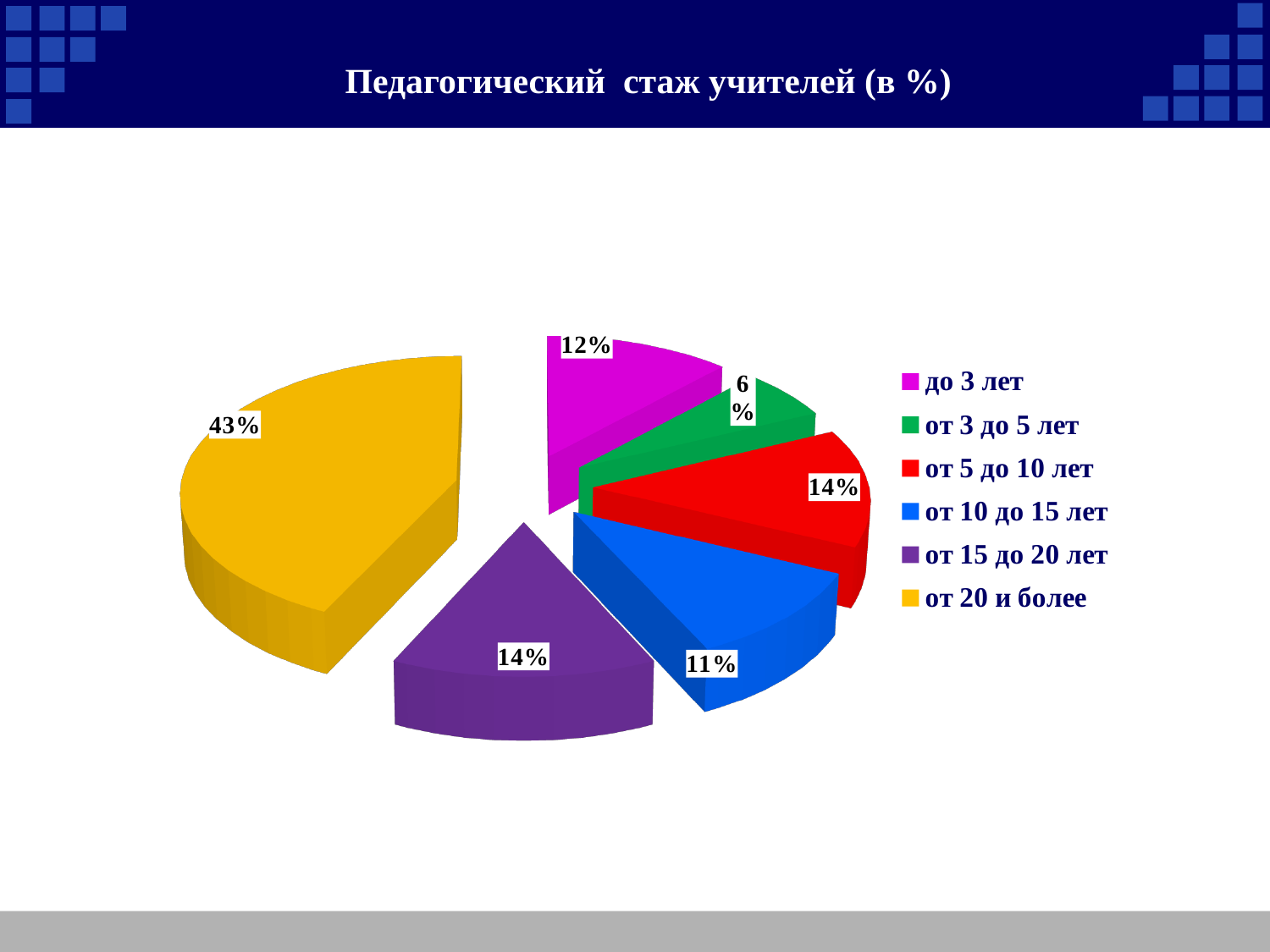
What type of chart is shown on the slide? Pie chart What is the value for the category 'от 5 до 10 лет'? 14% How many categories does the legend list? 6 What is the value for the category 'от 10 до 15 лет'? 11% What percentage of teachers have a teaching experience of 'до 3 лет'? 12% What is the difference between the values for 'от 20 и более' and 'до 3 лет'? 31% What is the value for the category 'от 3 до 5 лет'? 6% Which category has the smallest share of the pie? от 3 до 5 лет Which category has the largest share of the pie? от 20 и более What is the title of the chart? Педагогический стаж учителей (в %) What is the value for the category 'от 20 и более'? 43% Which is larger: the value for 'от 10 до 15 лет' or the value for 'от 15 до 20 лет'? от 15 до 20 лет